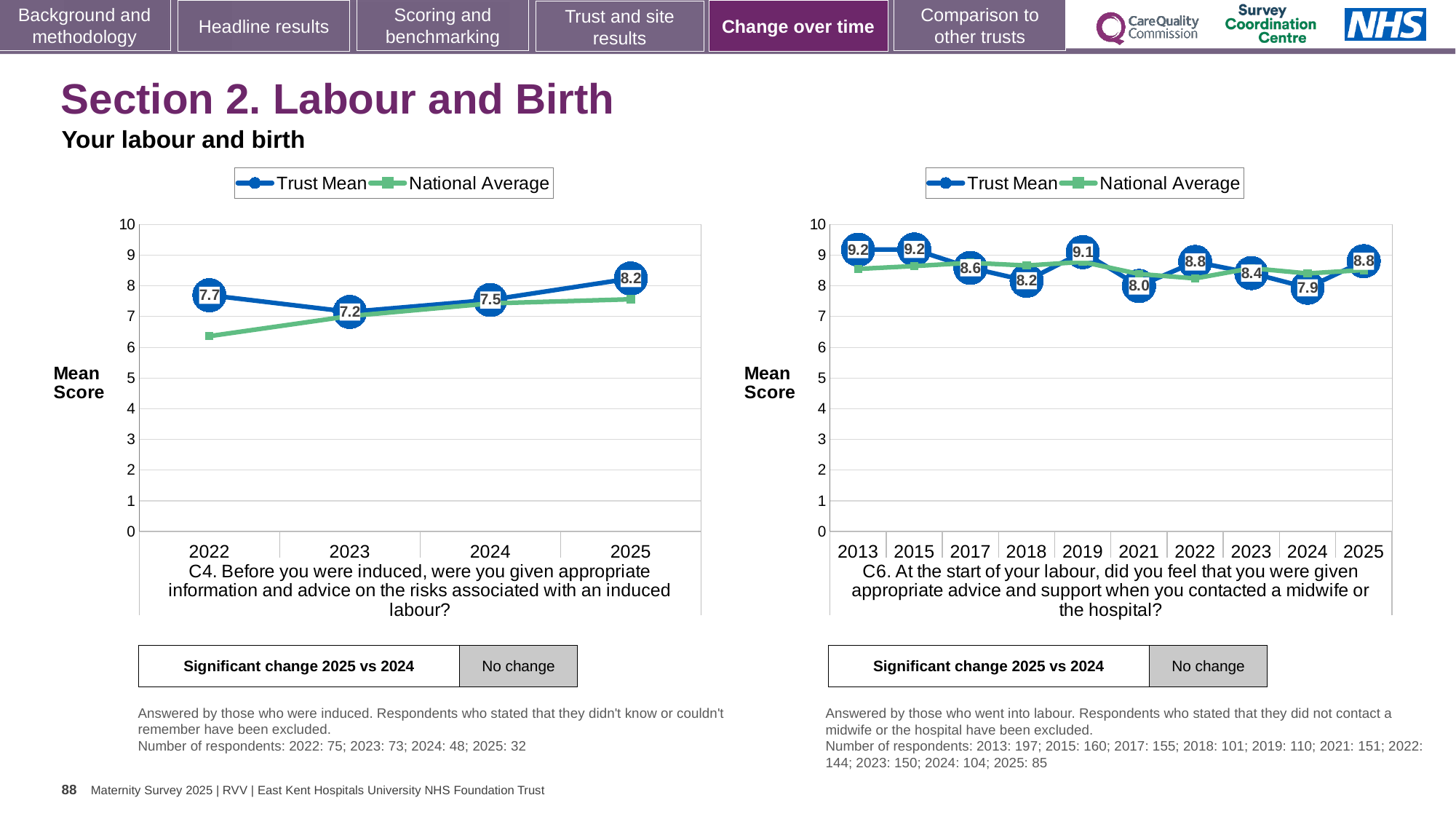
In the left chart (C4), is the National Average for 2022 greater or less than 7? less In the right chart (C6), what is the difference between the Trust Mean in 2013 and in 2024? 1.3 What type of chart is the left chart (C4)? Line chart In the right chart (C6), is the Trust Mean for 2019 larger than the Trust Mean for 2018? Yes In the left chart (C4), which year has the lowest Trust Mean? 2023 In the right chart (C6), how many years are shown on the x axis? 10 How many series does the legend of the right chart (C6) list? 2 In the left chart (C4), what is the Trust Mean for 2025? 8.2 In the right chart (C6), which year has the lowest Trust Mean? 2024 In the right chart (C6), what is the Trust Mean for 2021? 8.0 In the left chart (C4), how many years are shown on the x axis? 4 In the left chart (C4), what is the difference between the Trust Mean in 2025 and in 2024? 0.7